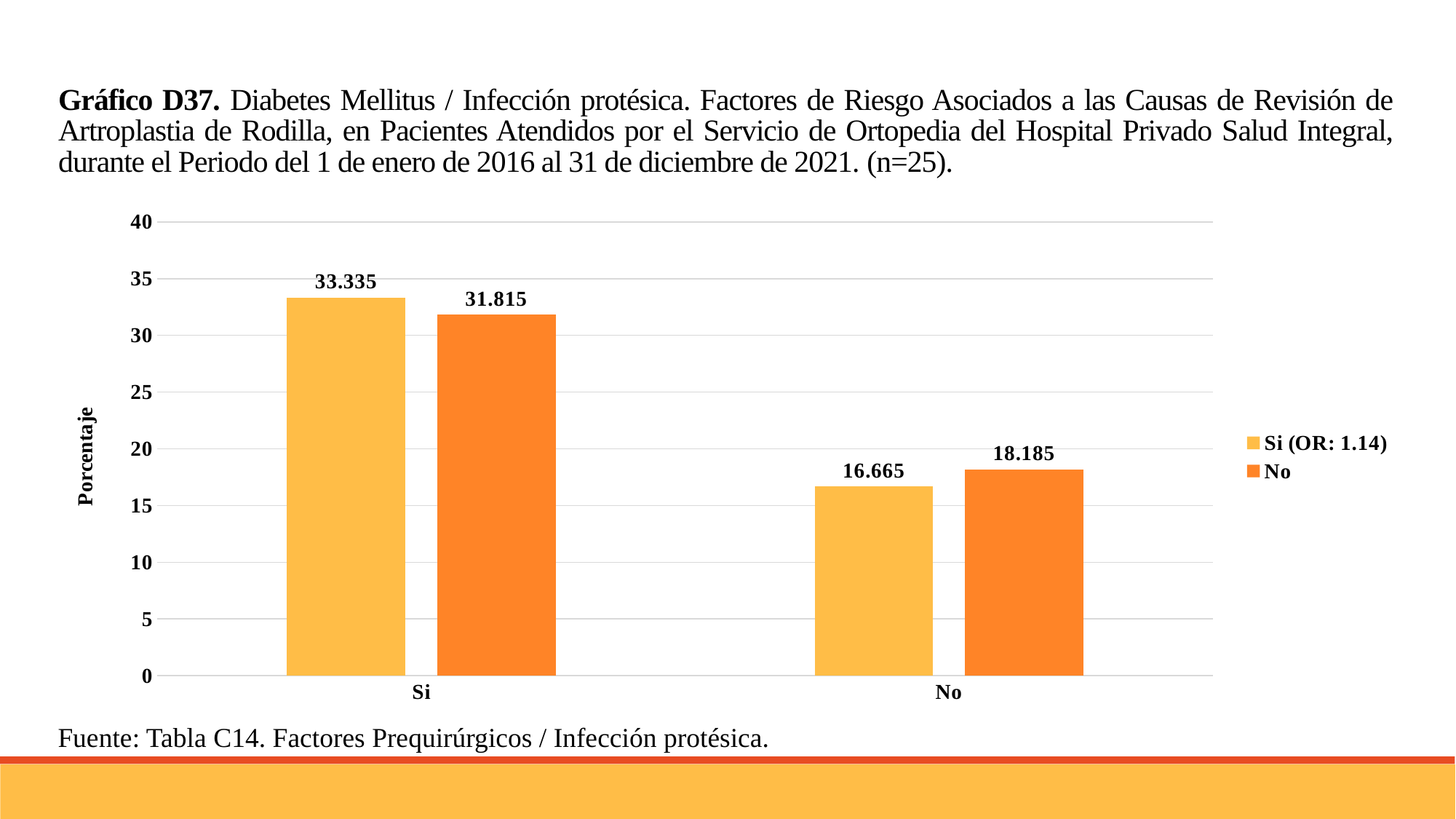
What is the difference between the "Si (OR: 1.14)" and "No" series values for the "Si" category? 1.52 Which bar has the highest value in the chart? Si (OR: 1.14) for the Si category What is the value of the "No" series for the "Si" category? 31.815 What is the value of the "No" series for the "No" category? 18.185 For the "No" category, which series has the larger value, "Si (OR: 1.14)" or "No"? No What kind of chart is shown on the slide? Bar chart What is the value of the "Si (OR: 1.14)" series for the "No" category? 16.665 What is the difference between the "No" and "Si (OR: 1.14)" series values for the "No" category? 1.52 How many categories are shown on the x axis? 2 What is the value of the "Si (OR: 1.14)" series for the "Si" category? 33.335 Which bar has the lowest value in the chart? Si (OR: 1.14) for the No category How many series does the legend list? 2